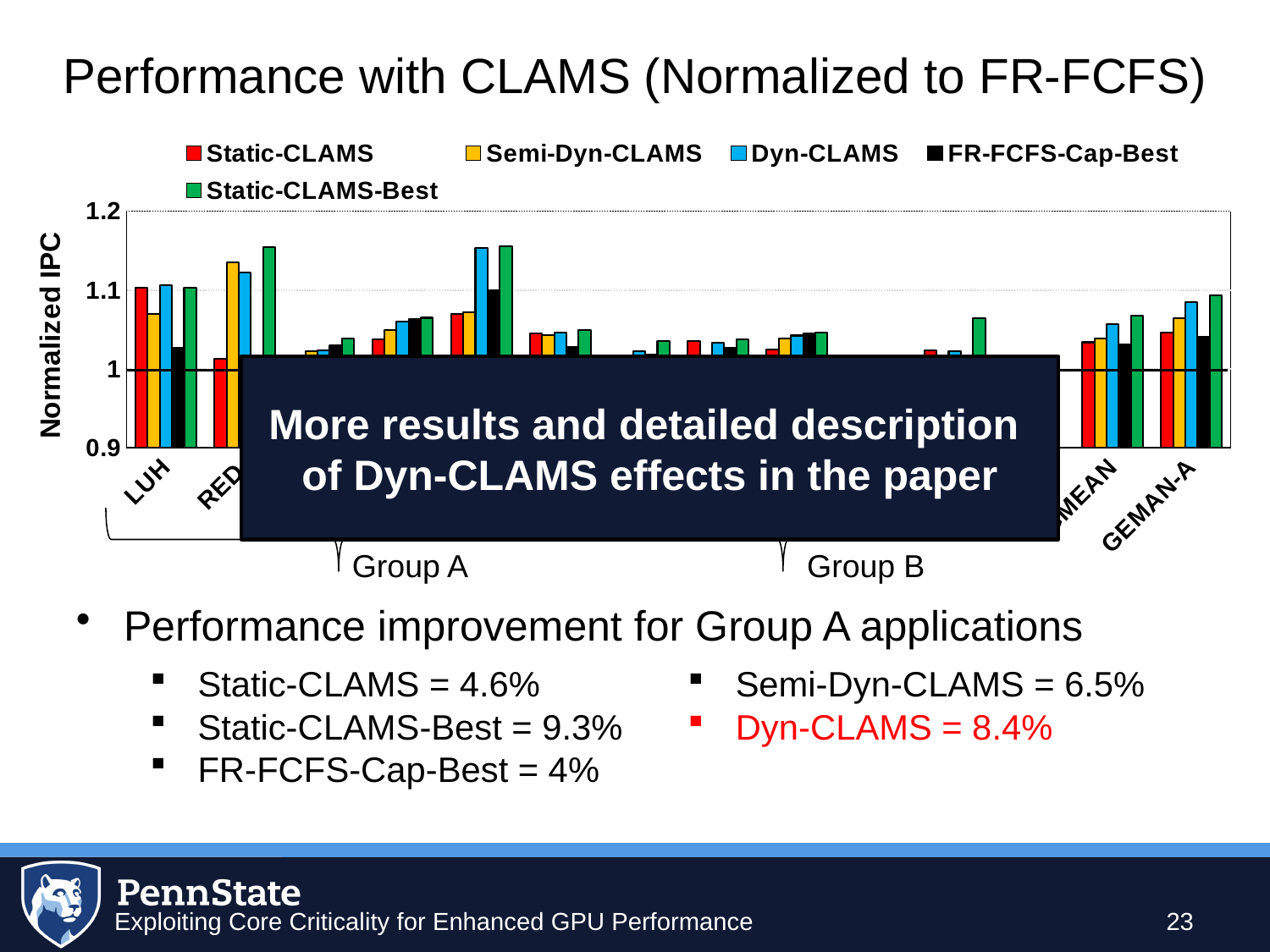
For GEMAN-A, which is larger: the Static-CLAMS-Best value or the FR-FCFS-Cap-Best value? Static-CLAMS-Best For GEMAN-A, which is larger: the Semi-Dyn-CLAMS value or the Dyn-CLAMS value? Dyn-CLAMS Is the FR-FCFS-Cap-Best value for LUH greater or less than 1.1? less Is the Static-CLAMS value for GEMAN-A greater or less than 1? greater What is the label of the vertical axis of the chart? Normalized IPC Which series is shown in light blue in the chart's legend? Dyn-CLAMS What kind of chart is shown on the slide? bar chart Is the Static-CLAMS value for LUH greater or less than 1? greater For LUH, which is larger: the Dyn-CLAMS value or the FR-FCFS-Cap-Best value? Dyn-CLAMS How many series does the chart's legend list? 5